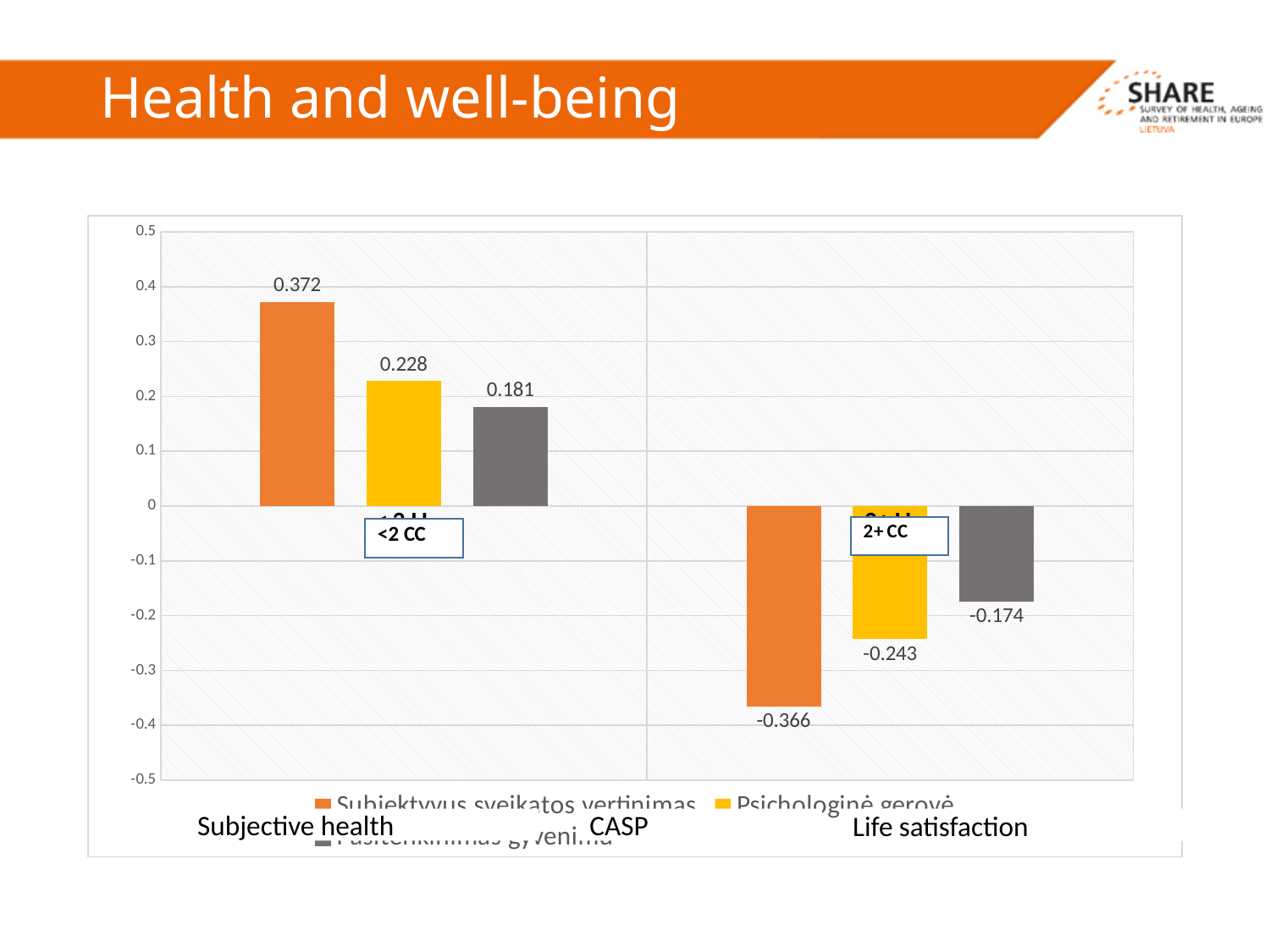
What is the difference between the Subjective health value and the CASP value in the <2 CC group? 0.144 What is the value for Subjective health in the 2+ CC group? -0.366 Is the value for CASP in the 2+ CC group greater or less than -0.2? less How many category groups are shown on the x axis? 2 Which series has the lowest value in the 2+ CC group? Subjective health Which is larger, the CASP value in the <2 CC group or the Life satisfaction value in the <2 CC group? CASP What kind of chart is shown on the slide? bar chart How many series does the chart show? 3 Which series has the highest value in the <2 CC group? Subjective health What is the value for Life satisfaction in the 2+ CC group? -0.174 What is the value for CASP in the <2 CC group? 0.228 What is the value for Subjective health in the <2 CC group? 0.372